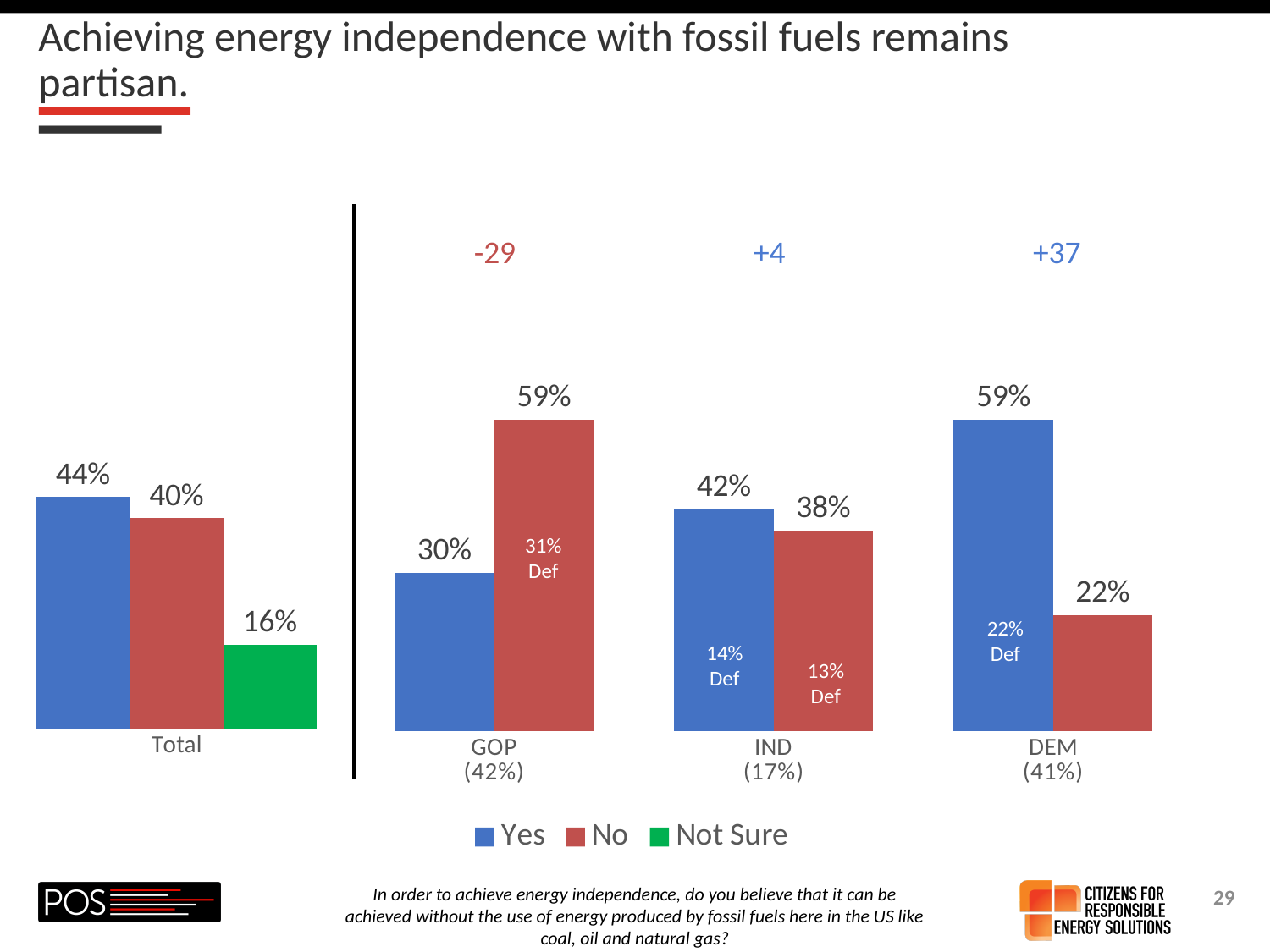
How many series does the legend list? 3 Which is larger for IND respondents, the Yes percentage or the No percentage? Yes What percentage of IND respondents answered No? 38% What is the difference between the No and Yes percentages for GOP? 29 percentage points What net figure is shown above the DEM bars? +37 What type of chart is shown on the slide? Bar chart What percentage of GOP respondents answered No? 59% What is the Not Sure percentage for the Total group? 16% What share of the sample is IND, as shown under the IND label? 17% Which party group has the lowest Yes percentage? GOP What percentage of DEM respondents answered Yes? 59% What percentage of the Total group answered Yes? 44%